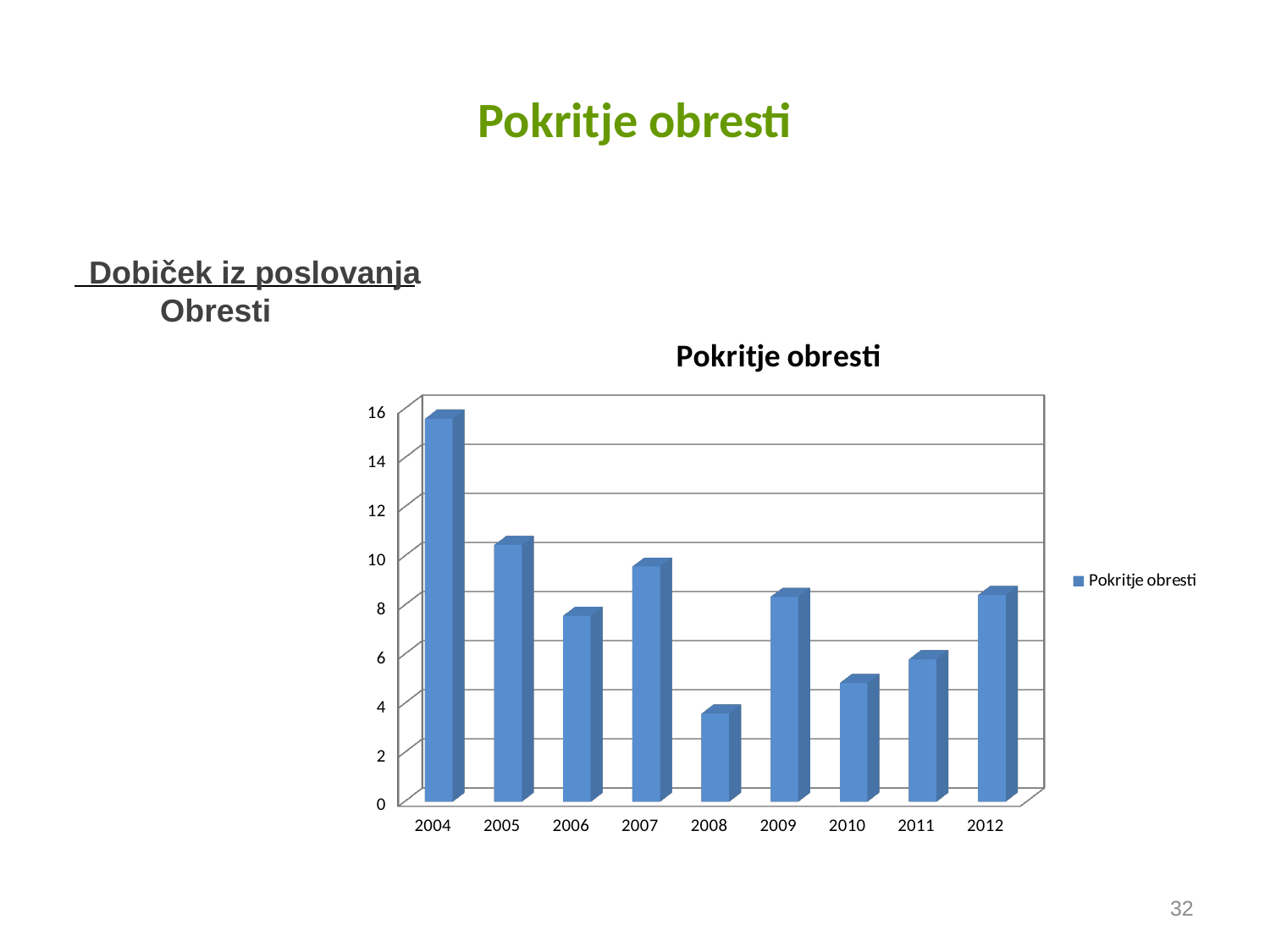
How many series does the legend list? 1 Is the value for 2008 greater or less than 4? less What kind of chart is shown on the slide? bar chart Is the value for 2010 greater or less than 6? less Which year has the lowest value in the chart? 2008 Is the value for 2004 greater or less than 14? greater Do the values rise or fall from 2004 to 2006? fall How many years are shown on the x axis of the chart? 9 Which year has the larger value, 2005 or 2006? 2005 What is the title of the chart? Pokritje obresti Which year has the highest value in the chart? 2004